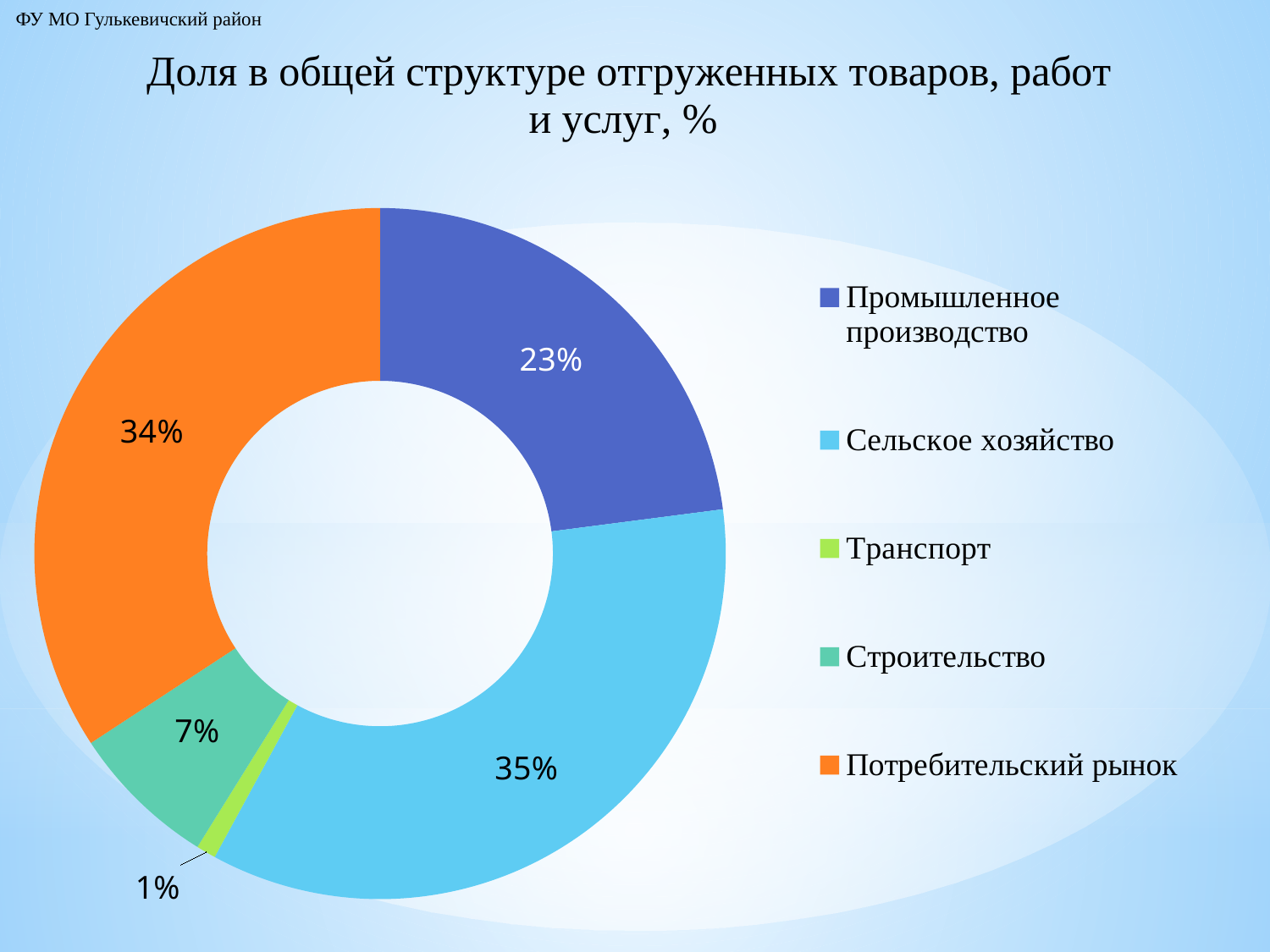
How many categories are shown in the chart? 5 What kind of chart is shown on the slide? doughnut chart What share does Строительство have in the chart? 7% Which category has the largest share in the chart? Сельское хозяйство What colour is the Потребительский рынок segment in the chart? orange What share does Промышленное производство have in the chart? 23% What share does Потребительский рынок have in the chart? 34% What is the difference between the shares of Потребительский рынок and Промышленное производство? 11% What share does Транспорт have in the chart? 1% Which has a larger share, Строительство or Промышленное производство? Промышленное производство What share does Сельское хозяйство have in the chart? 35% Which category has the smallest share in the chart? Транспорт